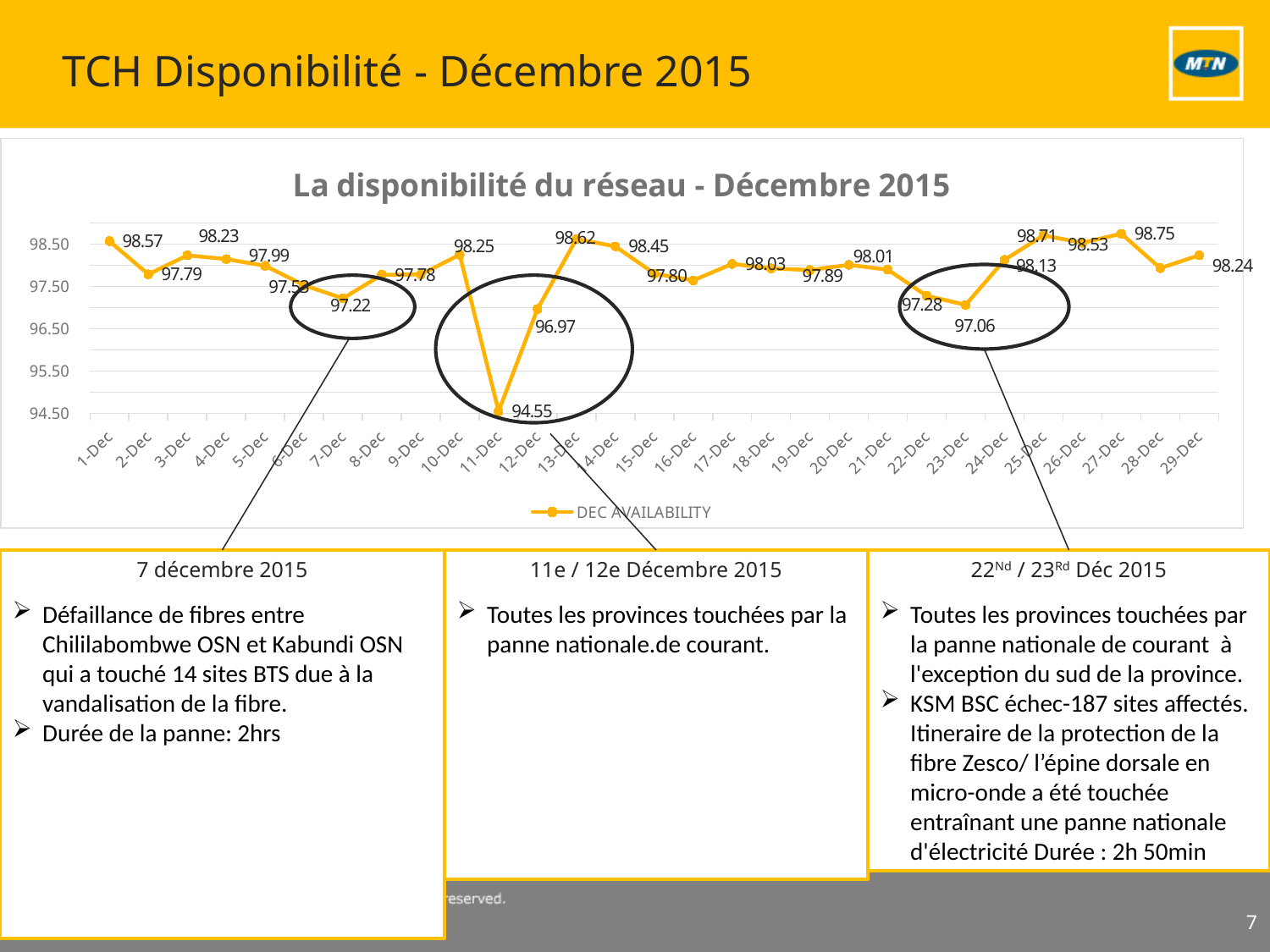
How many dates are plotted along the x axis? 29 How many series does the chart legend list? 1 Is the availability value on 11-Dec greater or less than 95.50? less What is the highest availability value labelled on the chart? 98.75 What is the name of the series shown in the legend? DEC AVAILABILITY What type of chart is shown on the slide? line chart What is the difference between the availability on 12-Dec (96.97) and on 11-Dec (94.55)? 2.42 What is the availability value on 1-Dec? 98.57 What is the availability value on 11-Dec? 94.55 What is the title of the chart? La disponibilité du réseau - Décembre 2015 On which date is the availability lowest? 11-Dec Which date has the higher availability, 1-Dec or 29-Dec? 1-Dec